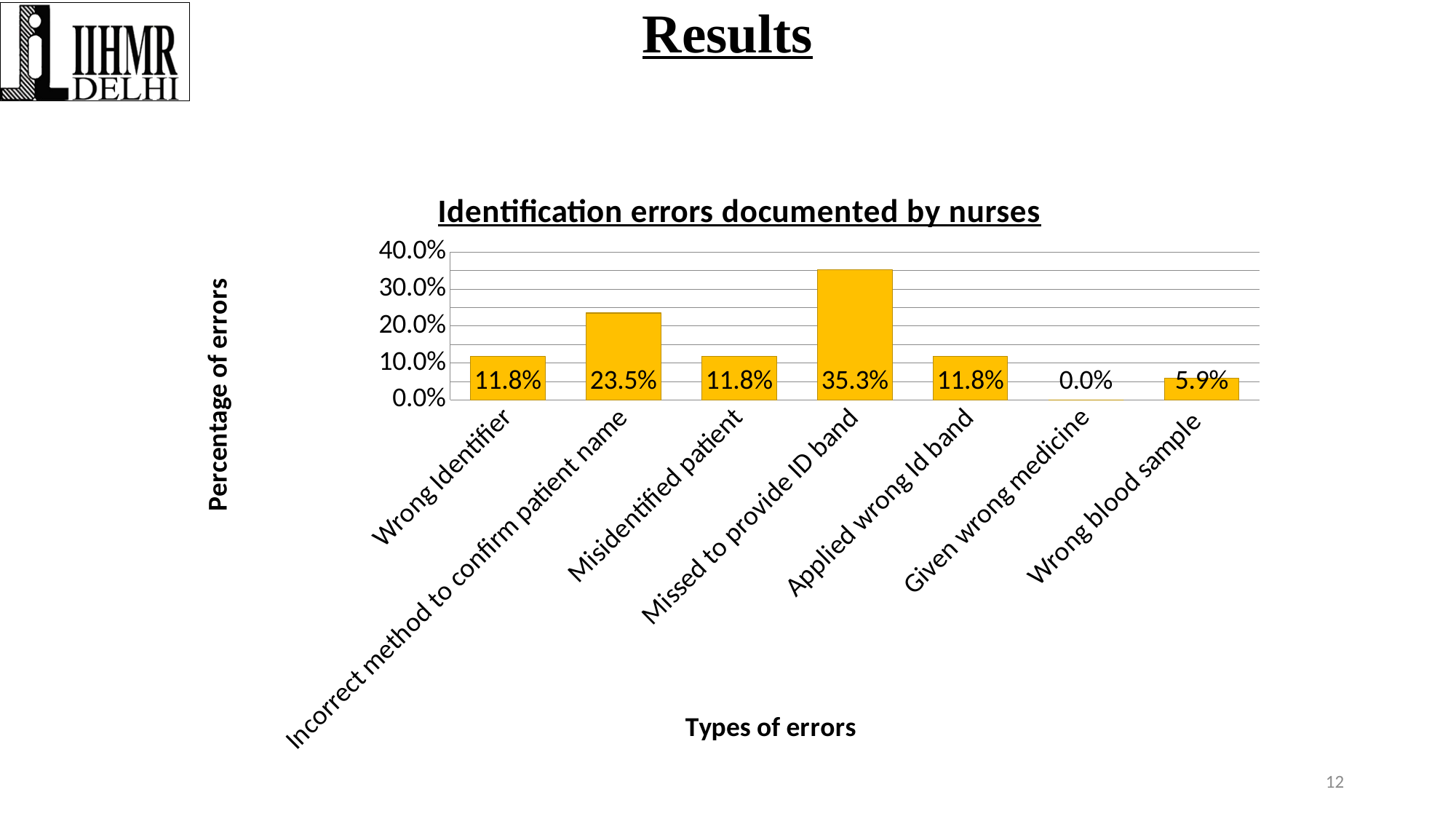
What is the value for Wrong blood sample? 5.9% What is the value for Given wrong medicine? 0.0% What kind of chart is shown? Bar chart What is the difference between Missed to provide ID band and Incorrect method to confirm patient name? 11.8% What is the title of the chart? Identification errors documented by nurses How many types of errors are shown on the x axis? 7 What is the value for Incorrect method to confirm patient name? 23.5% Which type of error has the highest percentage? Missed to provide ID band Which is larger, Wrong Identifier or Wrong blood sample? Wrong Identifier What is the value for Missed to provide ID band? 35.3% Is the value for Missed to provide ID band greater or less than 30.0%? greater Which type of error has the lowest percentage? Given wrong medicine